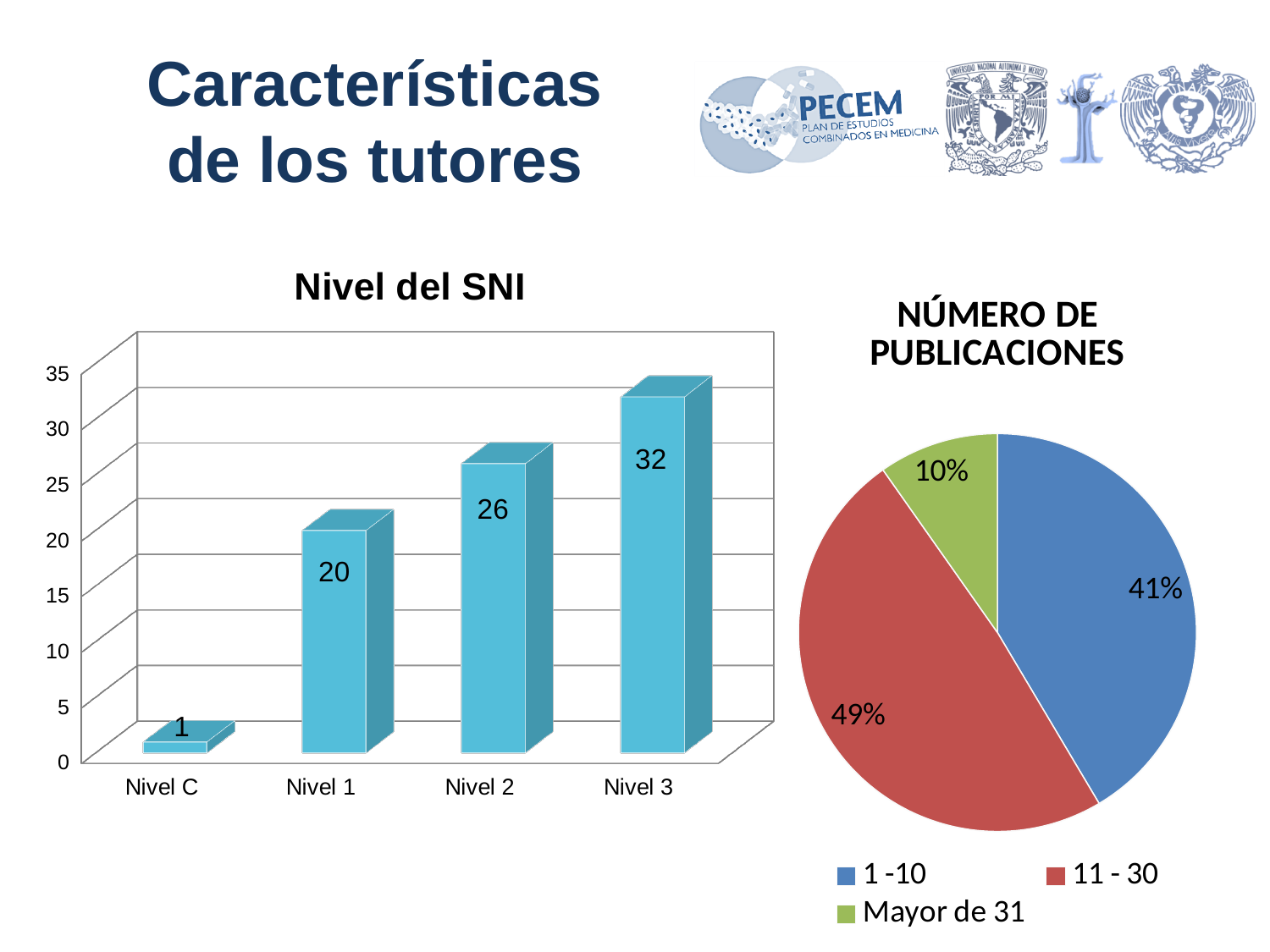
In the 'Nivel del SNI' chart, what is the difference between the values for Nivel 3 and Nivel 1? 12 In the 'Nivel del SNI' chart, what is the value for Nivel 2? 26 In the 'Nivel del SNI' chart, which category has the highest value? Nivel 3 In the 'Nivel del SNI' chart, what is the value for Nivel C? 1 In the 'Nivel del SNI' chart, which category has the lowest value? Nivel C In the 'Nivel del SNI' chart, which is larger, the value for Nivel 1 or the value for Nivel 2? Nivel 2 In the 'Nivel del SNI' chart, do the values rise or fall from Nivel C to Nivel 3? Rise In the 'NÚMERO DE PUBLICACIONES' chart, how many entries does the legend list? 3 What kind of chart is 'Nivel del SNI'? Bar chart In the 'Nivel del SNI' chart, how many categories are shown on the x axis? 4 In the 'NÚMERO DE PUBLICACIONES' chart, what share of the pie is '11 - 30'? 49% In the 'NÚMERO DE PUBLICACIONES' chart, which category has the smallest slice? Mayor de 31